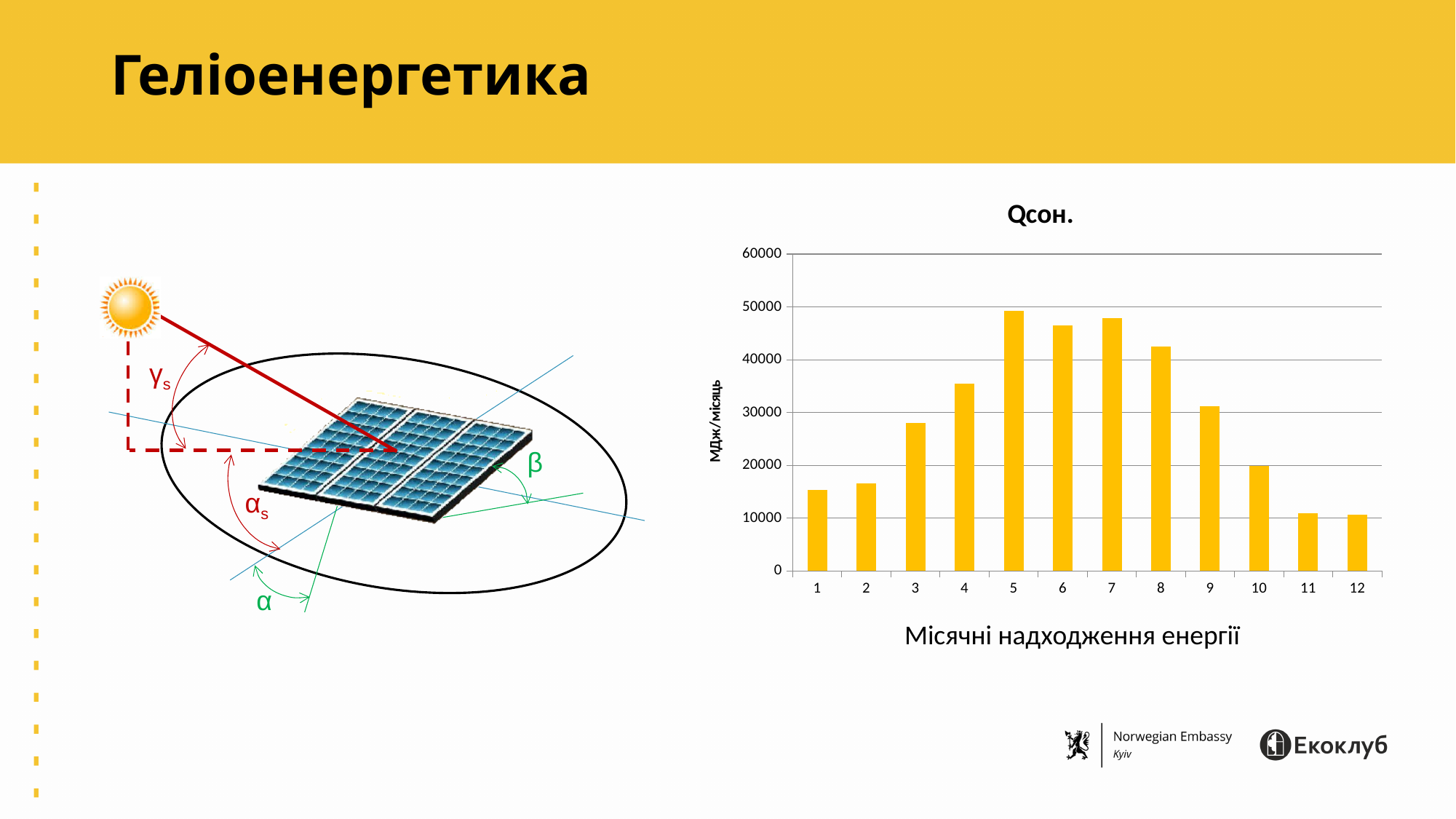
On the "Qсон." chart, which is larger: the value for month 4 or the value for month 9? month 4 What kind of chart is shown under the title "Qсон."? bar chart How many months (categories) are plotted on the "Qсон." chart? 12 Which month has the highest value on the "Qсон." chart? 5 On the "Qсон." chart, which is larger: the value for month 2 or the value for month 10? month 10 Is the value for month 3 on the "Qсон." chart greater or less than 30000? less Is the value for month 11 on the "Qсон." chart greater or less than 20000? less Is the value for month 5 on the "Qсон." chart greater or less than 40000? greater What is the label on the vertical axis of the "Qсон." chart? МДж/місяць On the "Qсон." chart, do the values rise or fall from month 7 to month 12? fall